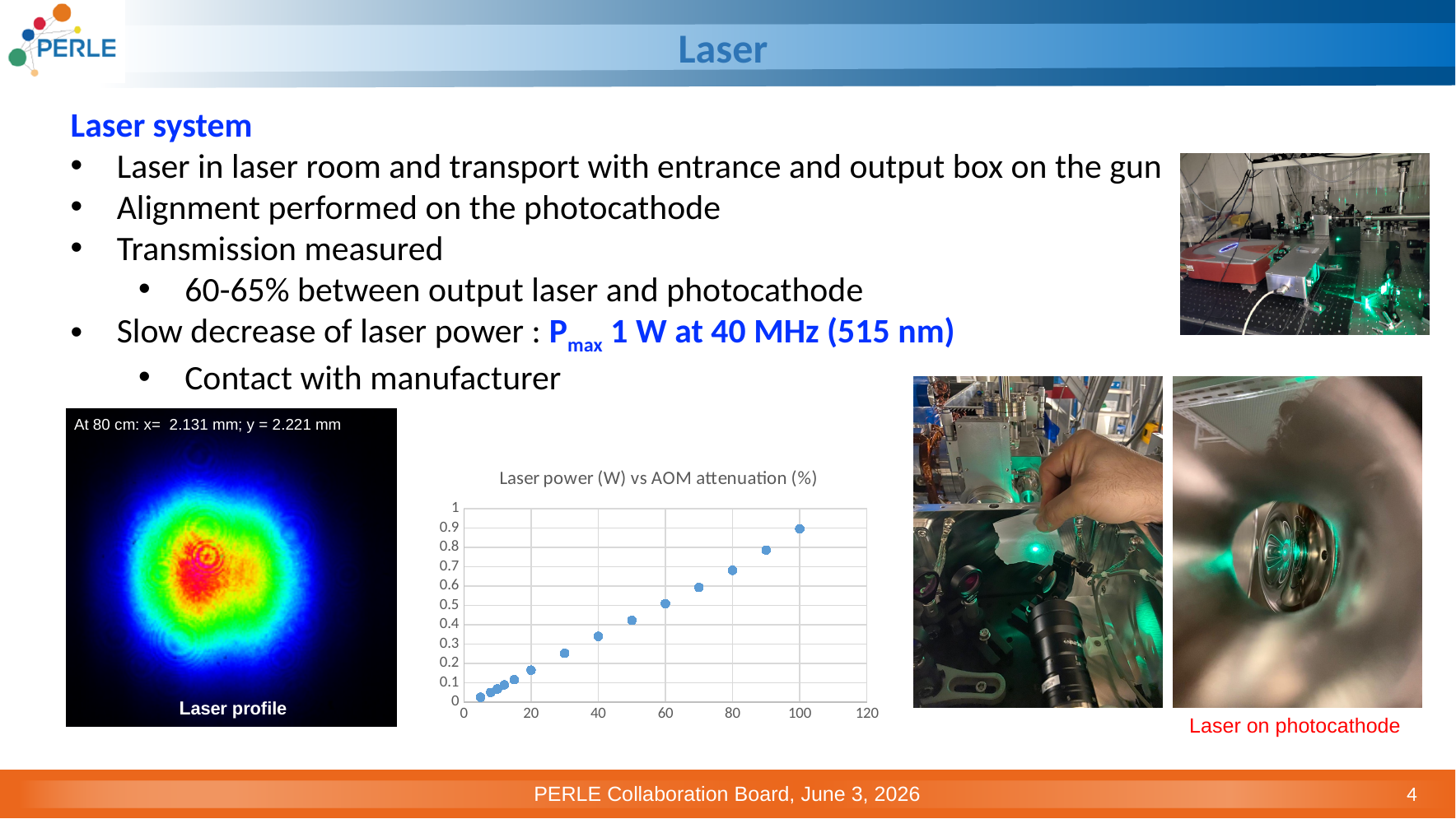
Is the laser power at 40% AOM attenuation greater or less than 0.4 W? less What is the title of the chart on the slide? Laser power (W) vs AOM attenuation (%) Is the laser power at 30% AOM attenuation greater or less than 0.3 W? less Is the laser power at 90% AOM attenuation greater or less than 0.7 W? greater What is the maximum value shown on the x axis of the chart? 120 At which AOM attenuation value is the laser power highest? 100 Which has the larger laser power: 40% or 100% AOM attenuation? 100% Do the plotted values rise or fall as AOM attenuation increases along the x axis? rise What kind of chart is shown on the slide? scatter chart